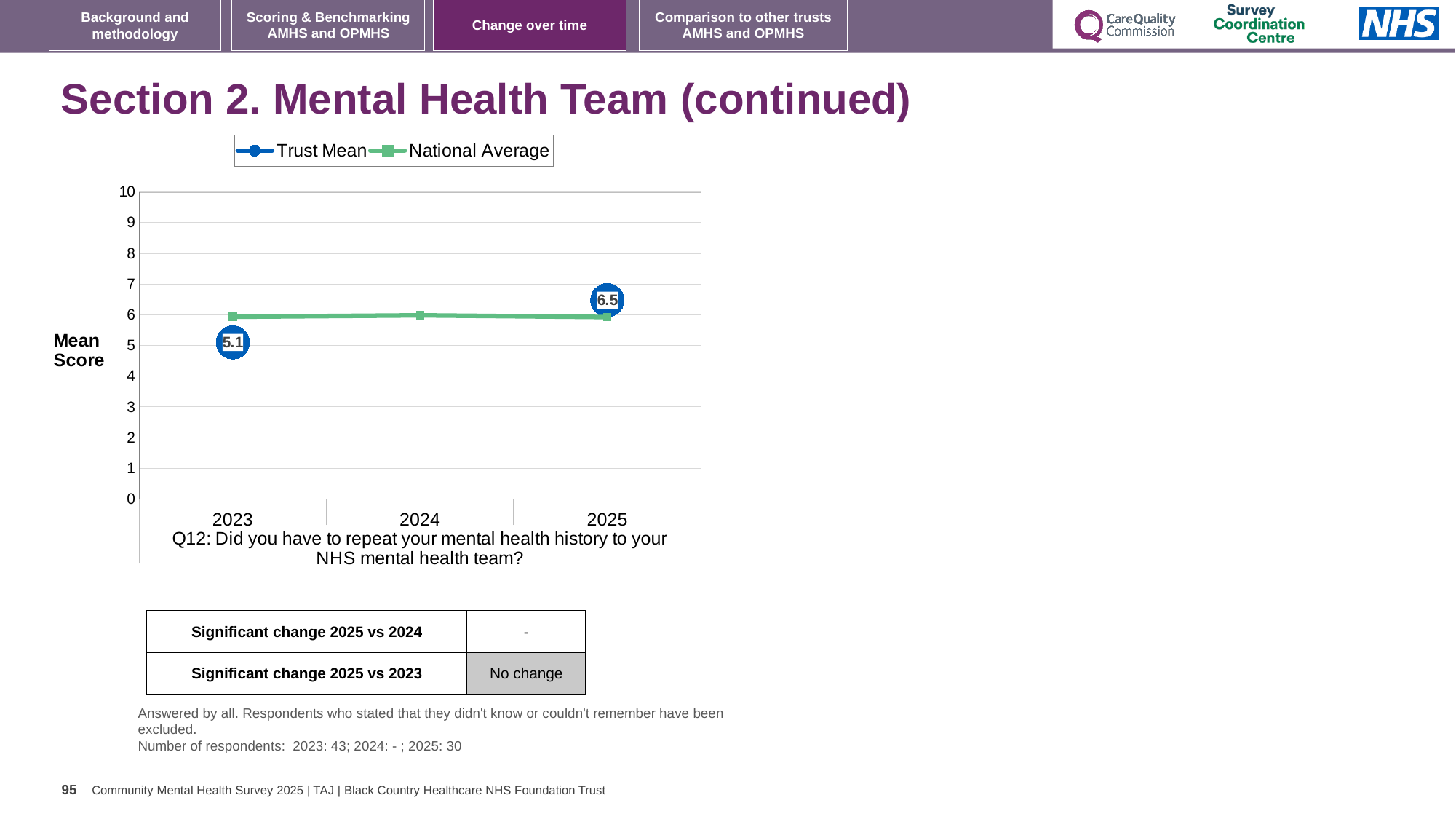
In 2023, which series is higher, Trust Mean or National Average? National Average Which year has the higher Trust Mean, 2023 or 2025? 2025 What is the Trust Mean value for 2023? 5.1 Is the National Average value for 2025 greater or less than 7? less Does the Trust Mean rise or fall from 2023 to 2025? rise How many series does the legend list? 2 What kind of chart is shown on the slide? line chart Is the National Average value for 2024 greater or less than 5? greater How many years are shown on the x axis? 3 What is the Trust Mean value for 2025? 6.5 What is the difference between the Trust Mean in 2025 and the Trust Mean in 2023? 1.4 In 2025, which series is higher, Trust Mean or National Average? Trust Mean